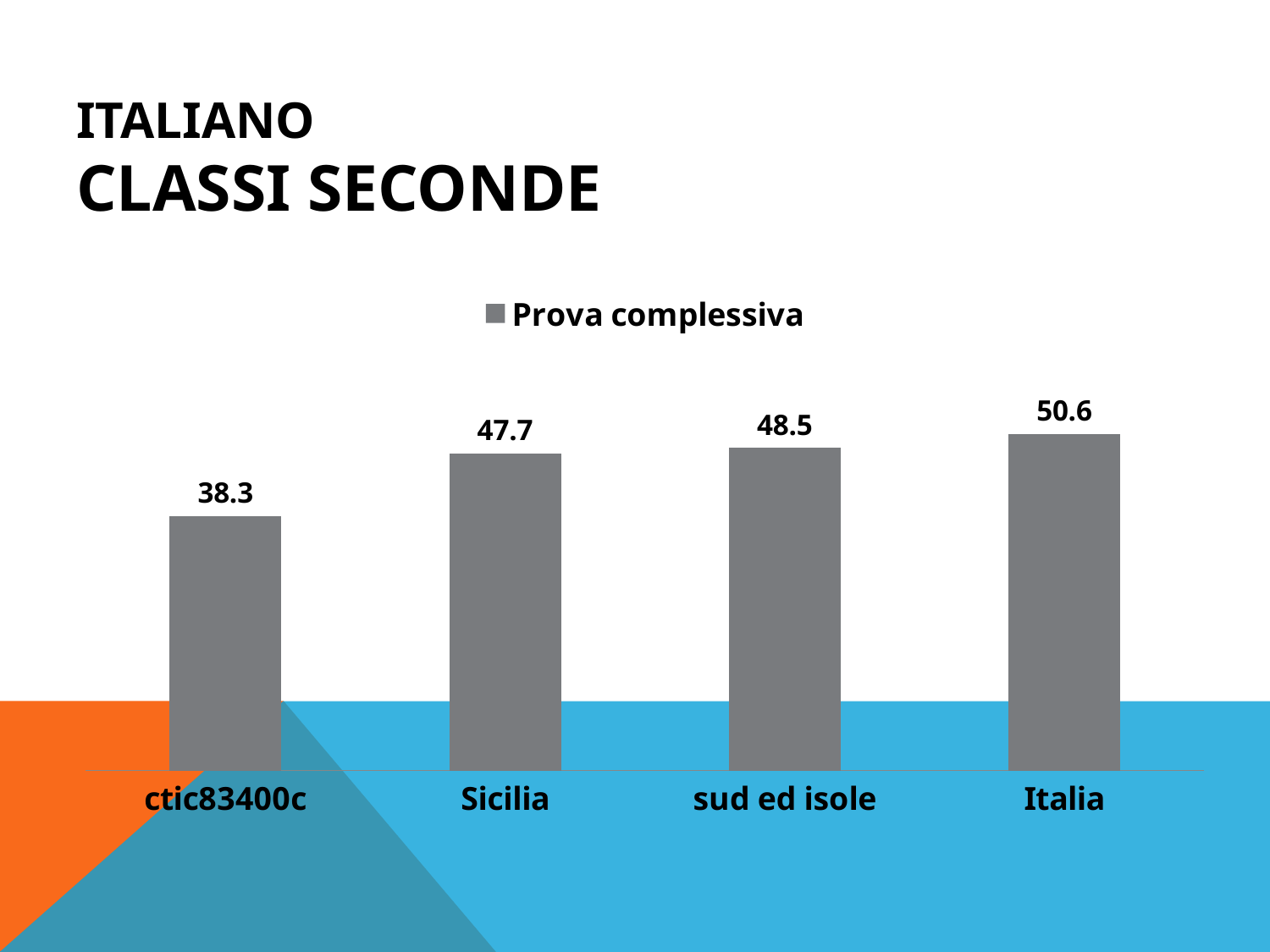
Which is larger, the value for Sicilia or the value for Italia? Italia What is the value for Sicilia? 47.7 What is the value for Italia? 50.6 What kind of chart is shown? bar chart What is the value for sud ed isole? 48.5 How many categories are shown on the x axis? 4 Which category has the highest value? Italia What is the value for ctic83400c? 38.3 What is the difference between the values for Italia and ctic83400c? 12.3 How many series does the legend list? 1 Which category has the lowest value? ctic83400c What is the difference between the values for Sicilia and ctic83400c? 9.4